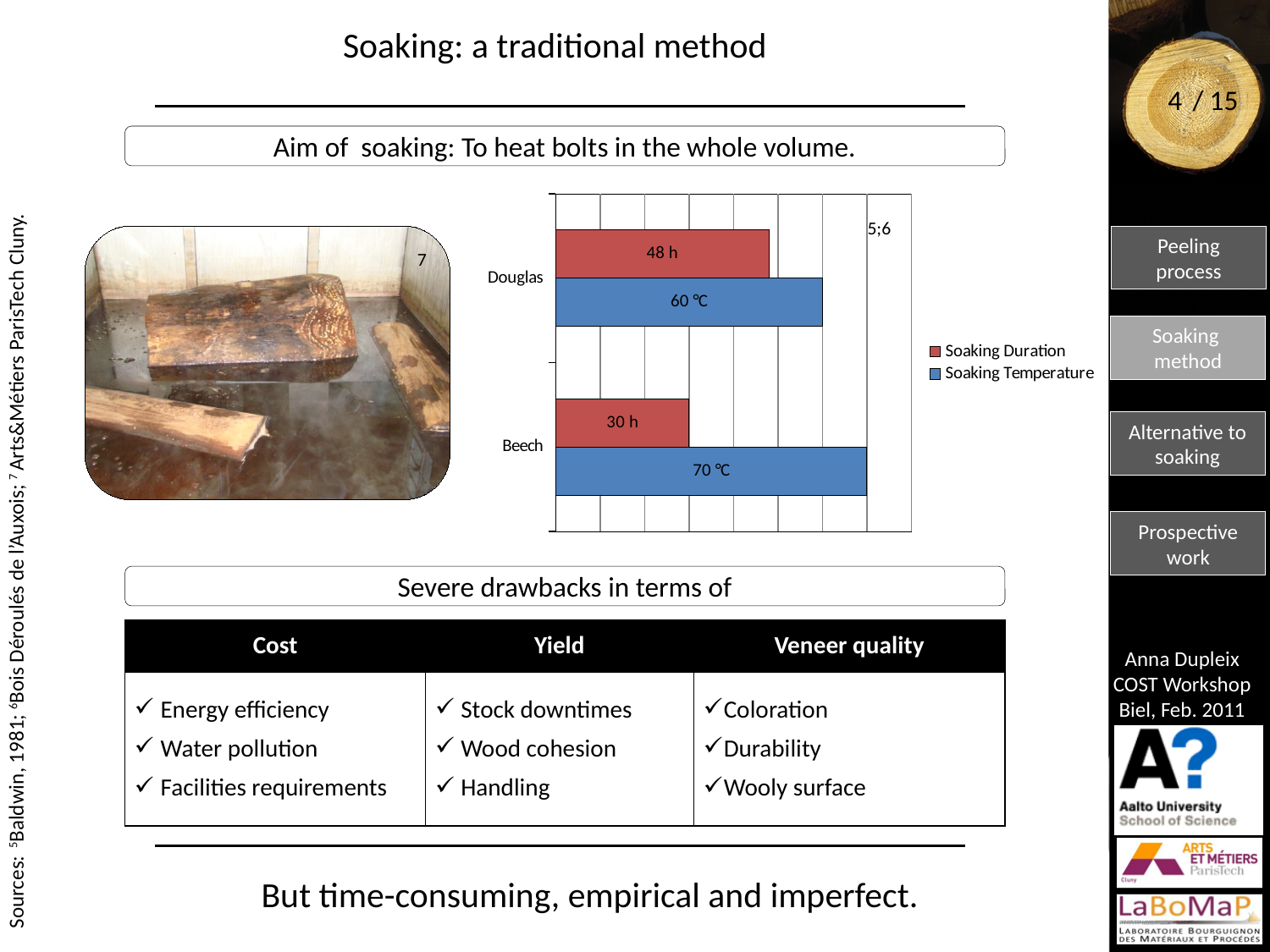
How many series does the chart legend list? 2 How much longer is the soaking duration for Douglas than for Beech? 18 h Which wood species has the longer soaking duration? Douglas How many wood species are shown on the chart? 2 Is the soaking temperature higher for Beech or for Douglas? Beech Which wood species has the lower soaking temperature? Douglas What is the difference in soaking temperature between Beech and Douglas? 10 °C What is the soaking duration for Douglas? 48 h What is the soaking duration for Beech? 30 h What is the soaking temperature for Douglas? 60 °C What is the soaking temperature for Beech? 70 °C What type of chart is used to show the soaking duration and temperature? Bar chart